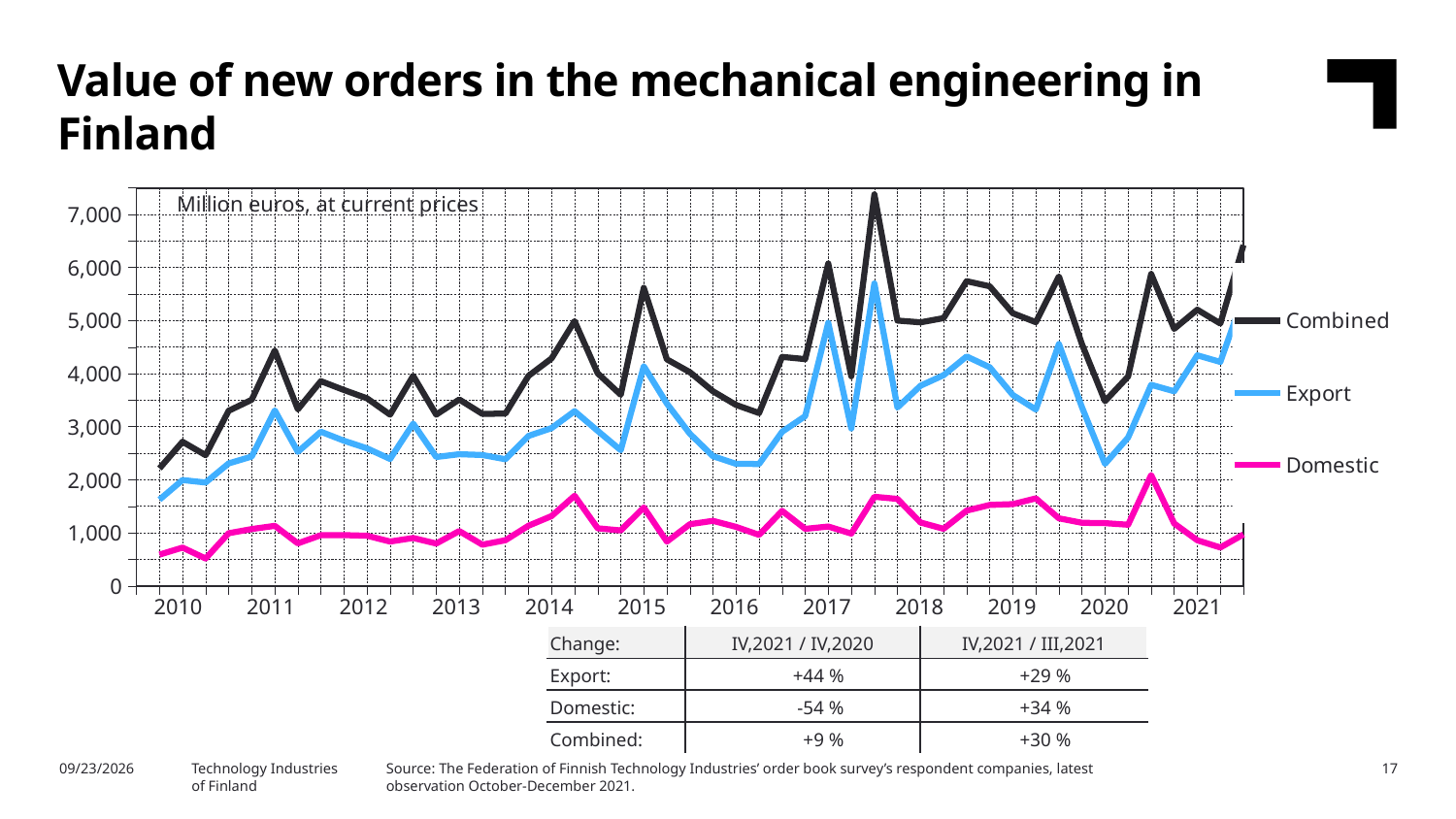
Is the peak value of the Export series in 2017 greater or less than 5,000? greater Which series has the highest values throughout the chart? Combined Which is larger at the end of 2021, the Combined value or the Export value? Combined Which series has the lowest values throughout the chart? Domestic Is the first Domestic value at the start of 2010 greater or less than 1,000? less Does the Combined series overall rise or fall from 2010 to 2021? rise What kind of chart is shown on the slide? line chart How many series does the legend list? 3 Is the peak value of the Combined series in 2017 greater or less than 7,000? greater How many year labels are shown on the x axis? 12 What unit is stated in the label at the top of the chart area? Million euros, at current prices